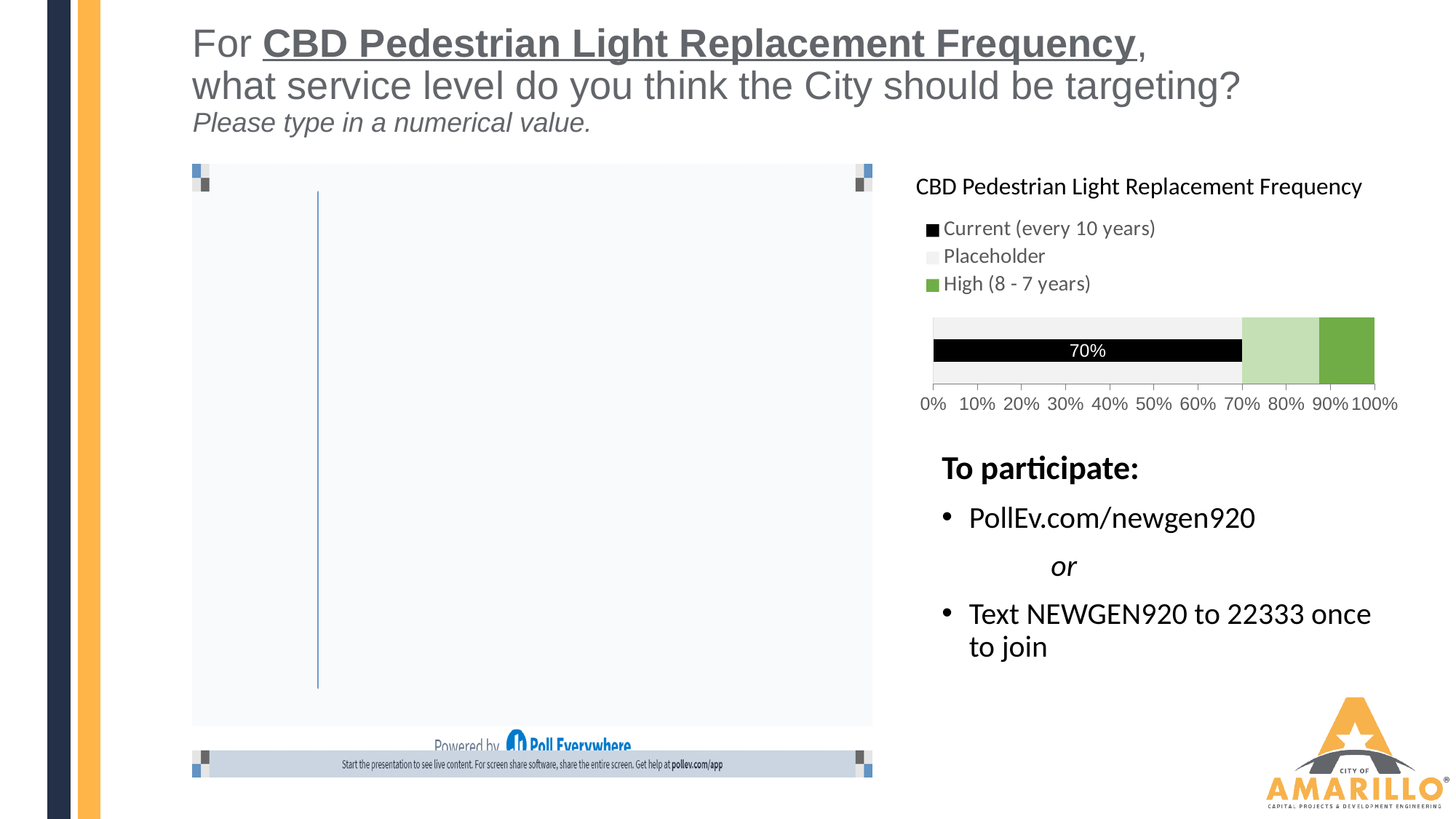
In the 'CBD Pedestrian Light Replacement Frequency' chart, is the value for 'Current (every 10 years)' greater or less than 80%? less What is the title of the chart on the right side of the slide? CBD Pedestrian Light Replacement Frequency What kind of chart is shown under the title 'CBD Pedestrian Light Replacement Frequency'? bar chart What is the highest value shown on the x axis of the 'CBD Pedestrian Light Replacement Frequency' chart? 100% In the 'CBD Pedestrian Light Replacement Frequency' chart, what replacement interval is given for the 'Current' series in the legend? every 10 years How many series does the legend of the 'CBD Pedestrian Light Replacement Frequency' chart list? 3 In the 'CBD Pedestrian Light Replacement Frequency' chart, is the value for 'Current (every 10 years)' greater or less than 50%? greater In the 'CBD Pedestrian Light Replacement Frequency' chart, what value is labelled on the black 'Current (every 10 years)' bar? 70%